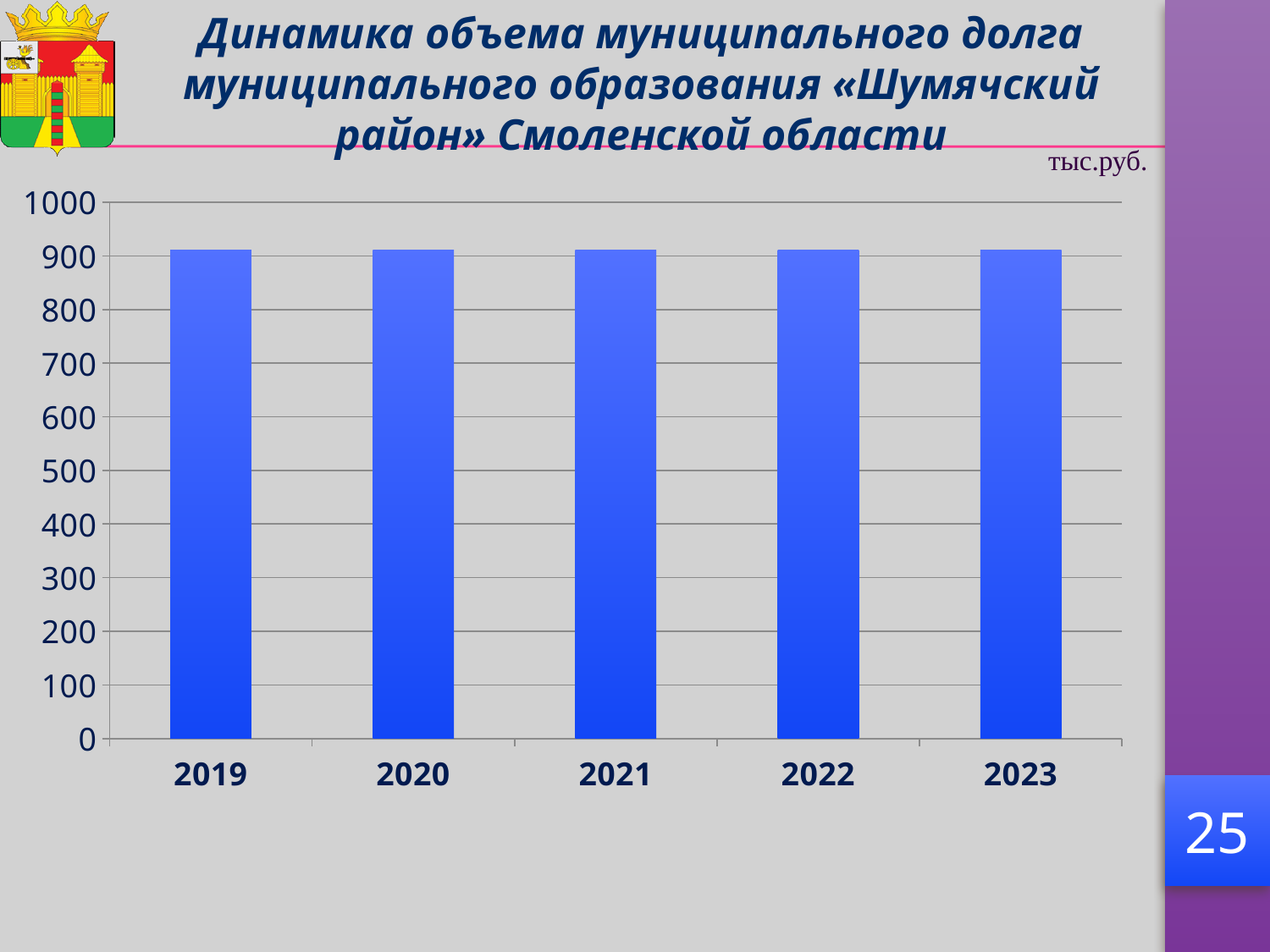
Is the value for 2021 greater or less than 1000? less How many years are shown on the x axis of the chart? 5 Is the value for 2019 greater or less than 800? greater Do the values rise, fall, or stay the same from 2019 to 2023? stay the same What unit of measurement is indicated above the chart? тыс.руб. What is the first year shown on the x axis? 2019 What kind of chart is shown on the slide? bar chart Is the value for 2023 greater or less than 500? greater What is the highest value shown on the y axis? 1000